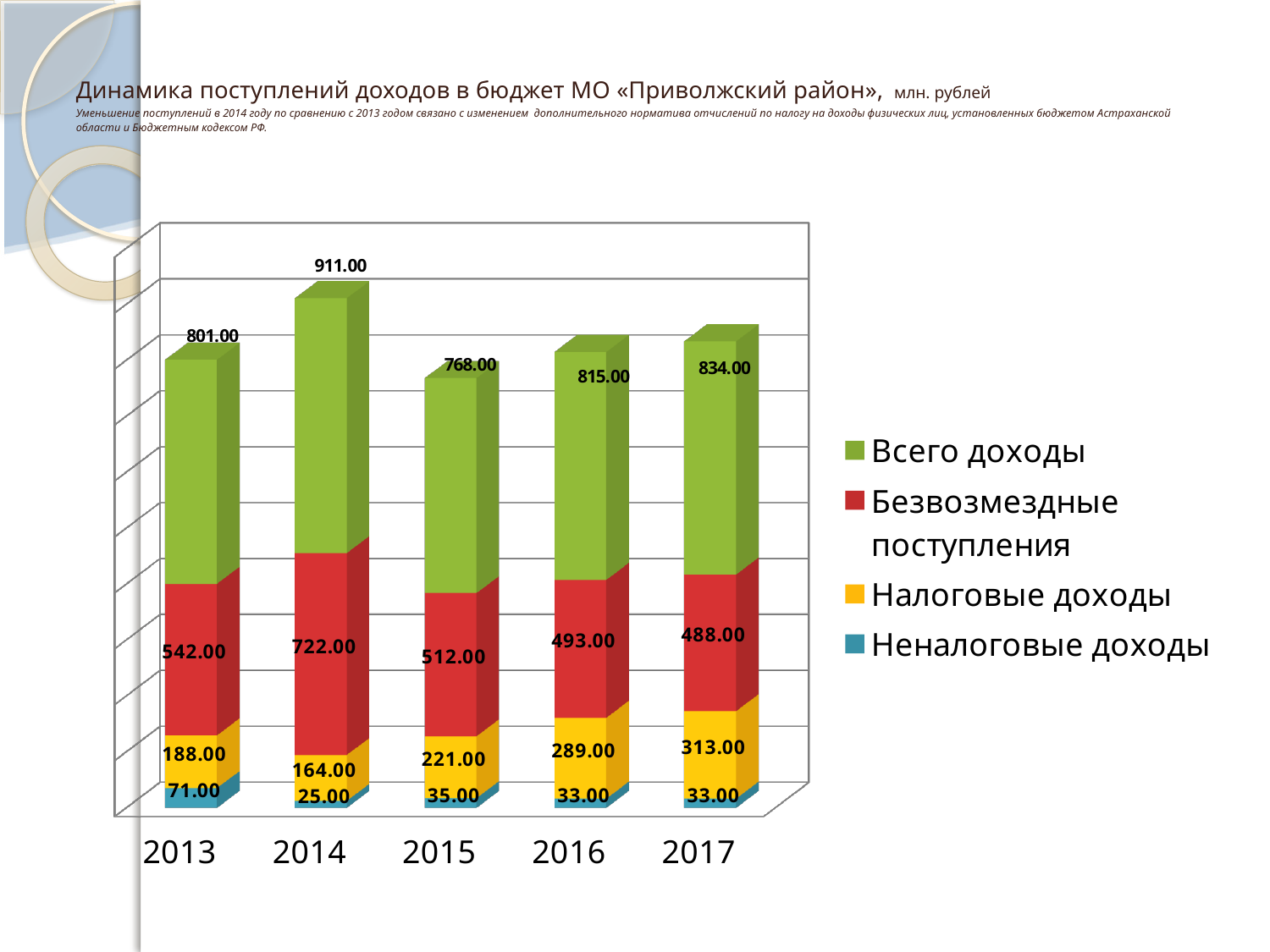
In which year is Неналоговые доходы the lowest? 2014 What is the difference between Всего доходы in 2014 and in 2015? 143.00 Does Налоговые доходы rise or fall from 2014 to 2017? Rise What is the value of Налоговые доходы for 2017? 313.00 What is the value of Всего доходы for 2014? 911.00 Which is larger: Налоговые доходы in 2016 or in 2015? 2016 In which year is Всего доходы the highest? 2014 How many series does the legend list? 4 What is the value of Неналоговые доходы for 2013? 71.00 How many years are shown on the x axis? 5 What is the value of Безвозмездные поступления for 2015? 512.00 What kind of chart is shown on the slide? Stacked bar chart